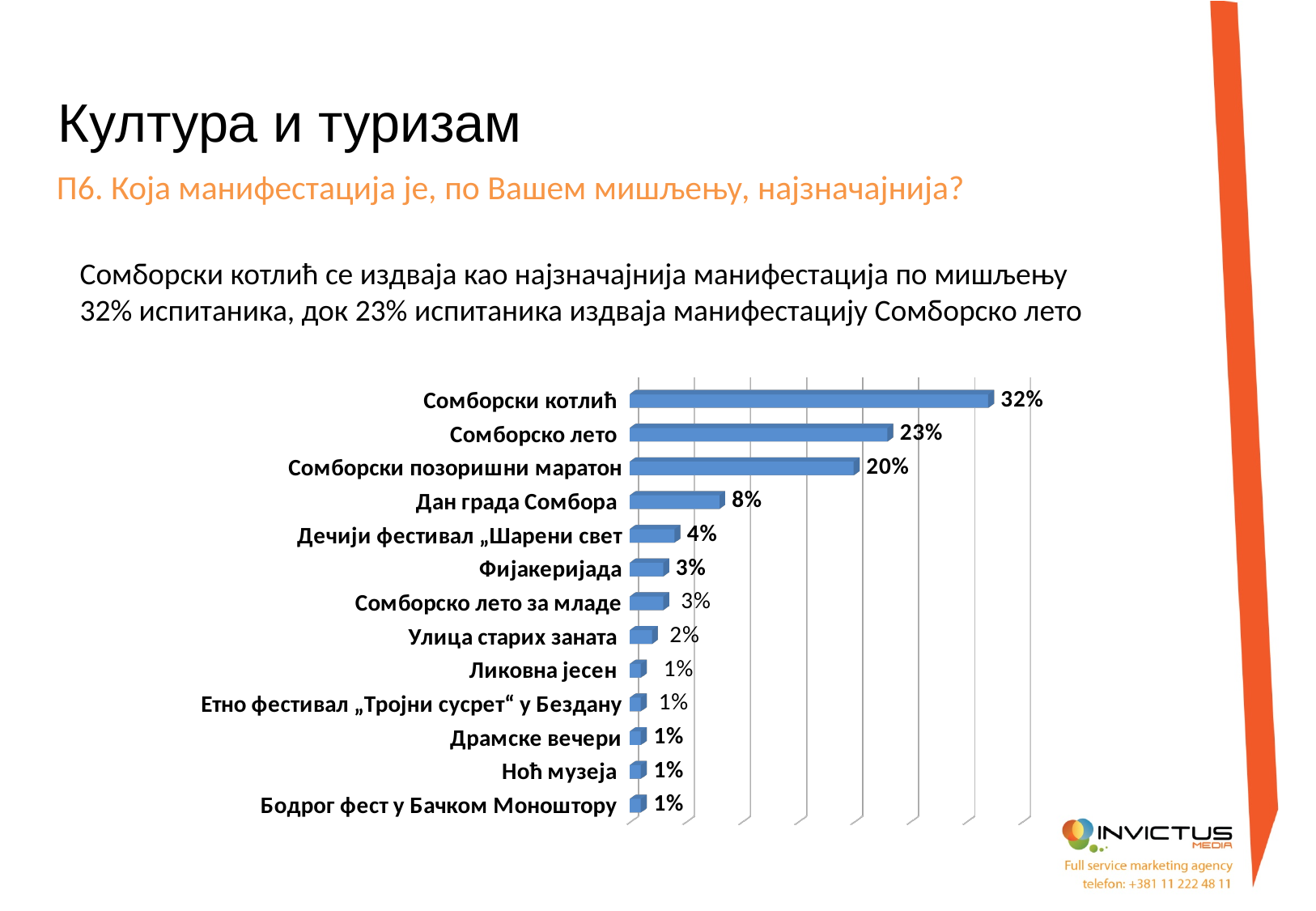
Which is larger, the value for Дан града Сомбора or the value for Фијакеријада? Дан града Сомбора What is the value for Сомборски позоришни маратон? 20% What kind of chart is shown on the slide? bar chart What colour are the bars in the chart? blue What is the value for Сомборски котлић? 32% What is the difference between the values for Сомборско лето and Сомборски позоришни маратон? 3% What is the value for Дан града Сомбора? 8% How many categories are shown in the chart? 13 How many categories have a value of 1%? 5 What is the value for Улица старих заната? 2% Which category has the highest value? Сомборски котлић What is the difference between the values for Сомборски котлић and Сомборско лето? 9%